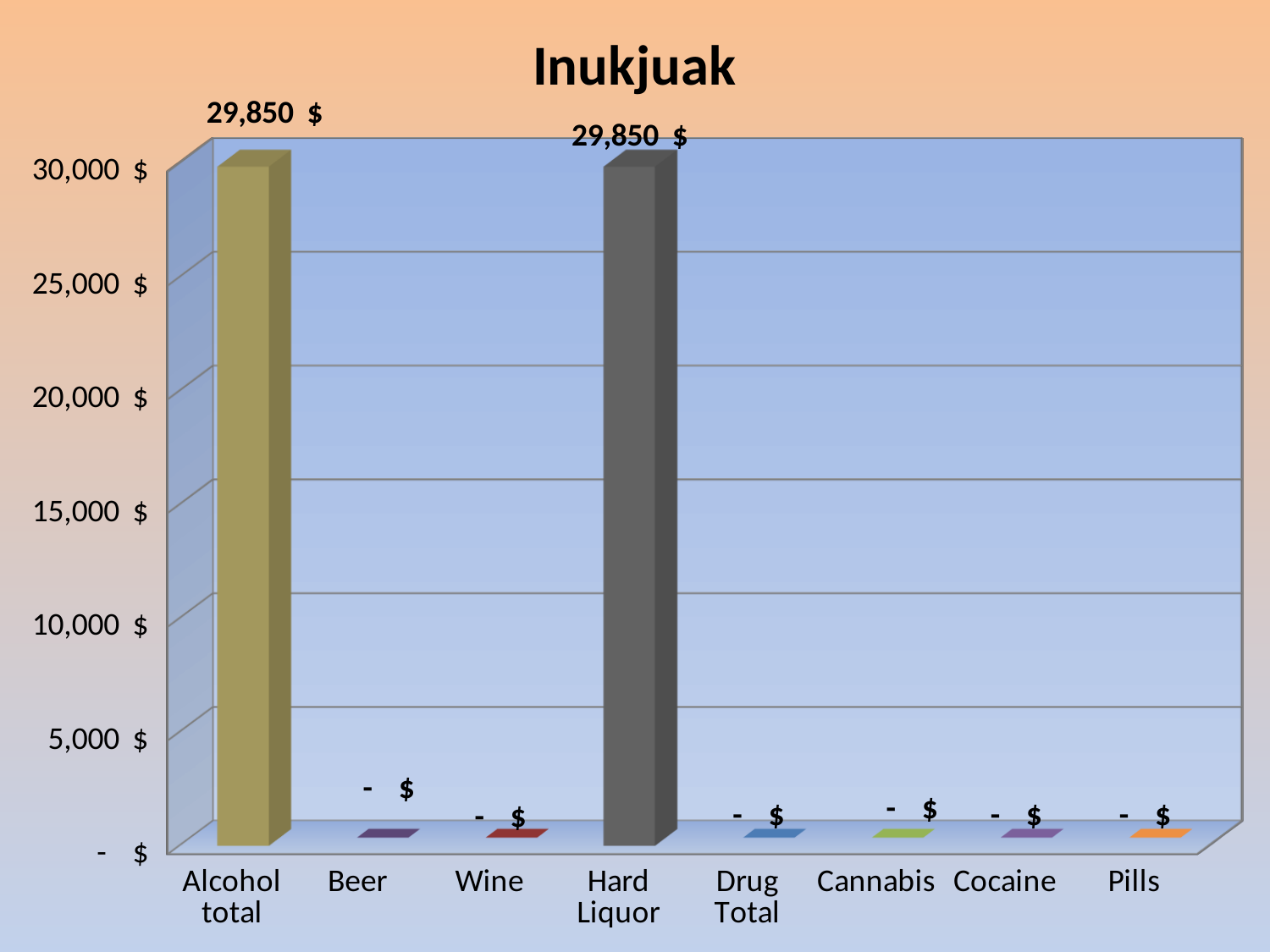
Is the value for Hard Liquor greater or less than 20,000 $? greater What is the title of the chart? Inukjuak What is the value for Alcohol total? 29,850 $ What is the difference between the value for Alcohol total and the value for Hard Liquor? - $ What is the value for Hard Liquor? 29,850 $ Which is larger, the value for Hard Liquor or the value for Drug Total? Hard Liquor What value is shown for Beer? - $ Which is larger, the value for Alcohol total or the value for Beer? Alcohol total How many categories are shown on the x axis? 8 What value is shown for Cannabis? - $ What kind of chart is this? Bar chart Is the value for Alcohol total greater or less than 25,000 $? greater